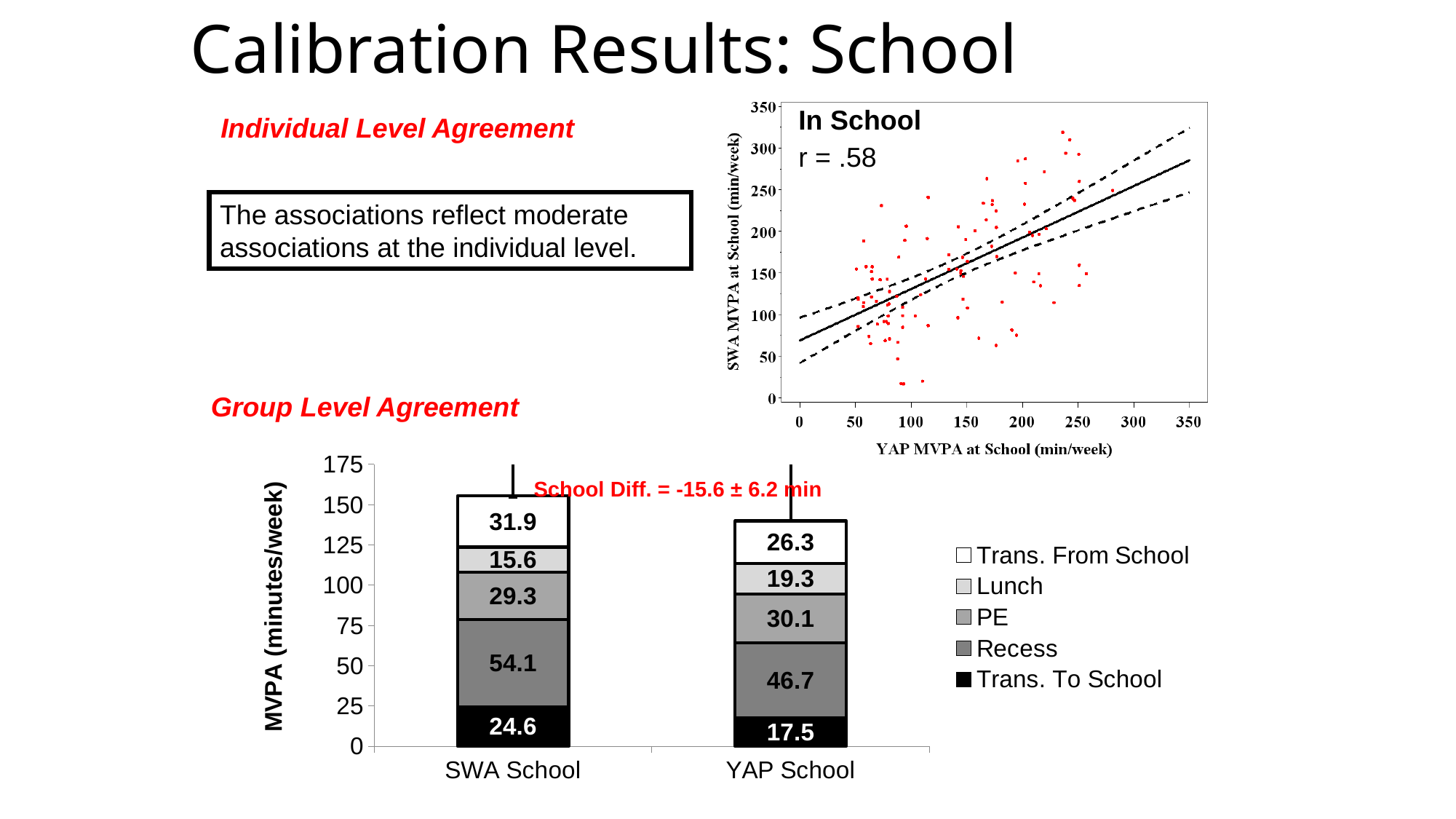
In the stacked bar chart, what is the Trans. To School value for YAP School? 17.5 What type of chart is the 'In School' chart in the top right? Scatter plot In the stacked bar chart, what is the difference between the Recess values for SWA School and YAP School? 7.4 In the stacked bar chart, which segment is largest within the SWA School bar? Recess In the stacked bar chart, what is the total of the YAP School bar? 139.9 In the stacked bar chart, which segment is smallest within the YAP School bar? Trans. To School In the stacked bar chart, what is the Lunch value for YAP School? 19.3 In the stacked bar chart, what is the Recess value for SWA School? 54.1 In the stacked bar chart, what is the total of the SWA School bar? 155.5 What correlation coefficient is shown on the 'In School' scatter plot? r = .58 In the stacked bar chart, is the Trans. From School value larger for SWA School or YAP School? SWA School How many series does the legend of the stacked bar chart list? 5